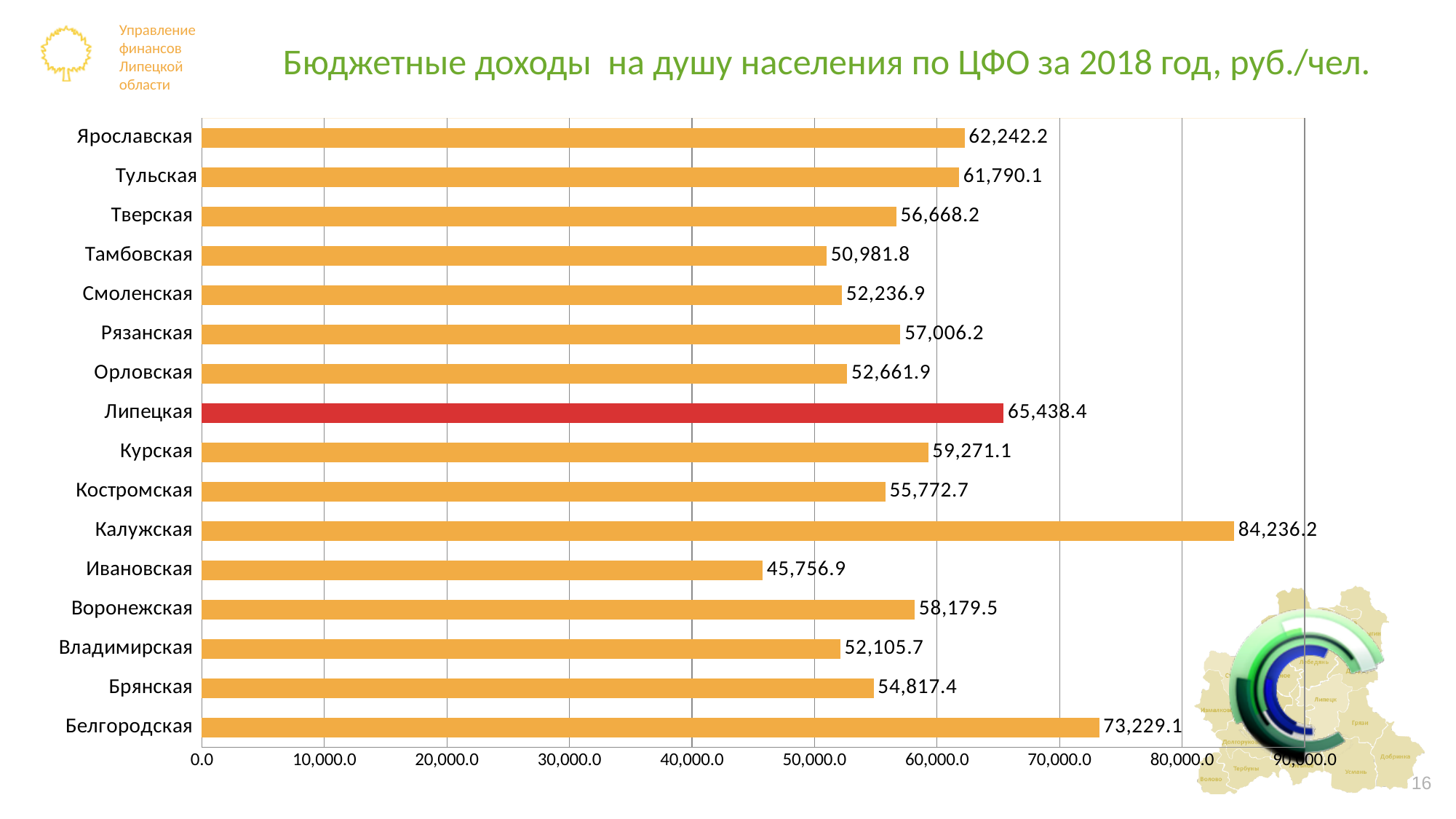
What is the difference between the values for Белгородская and Липецкая? 7,790.7 Which region has the highest value? Калужская Which region has the lowest value? Ивановская What is the difference between the values for Калужская and Липецкая? 18,797.8 How many regions are shown in the chart? 16 Is the value for Ивановская greater or less than 50,000.0? less Which is larger, the value for Липецкая or the value for Белгородская? Белгородская What is the value for Калужская? 84,236.2 What is the value for Белгородская? 73,229.1 What is the value for Липецкая? 65,438.4 What is the value for Ивановская? 45,756.9 What kind of chart is shown on the slide? bar chart